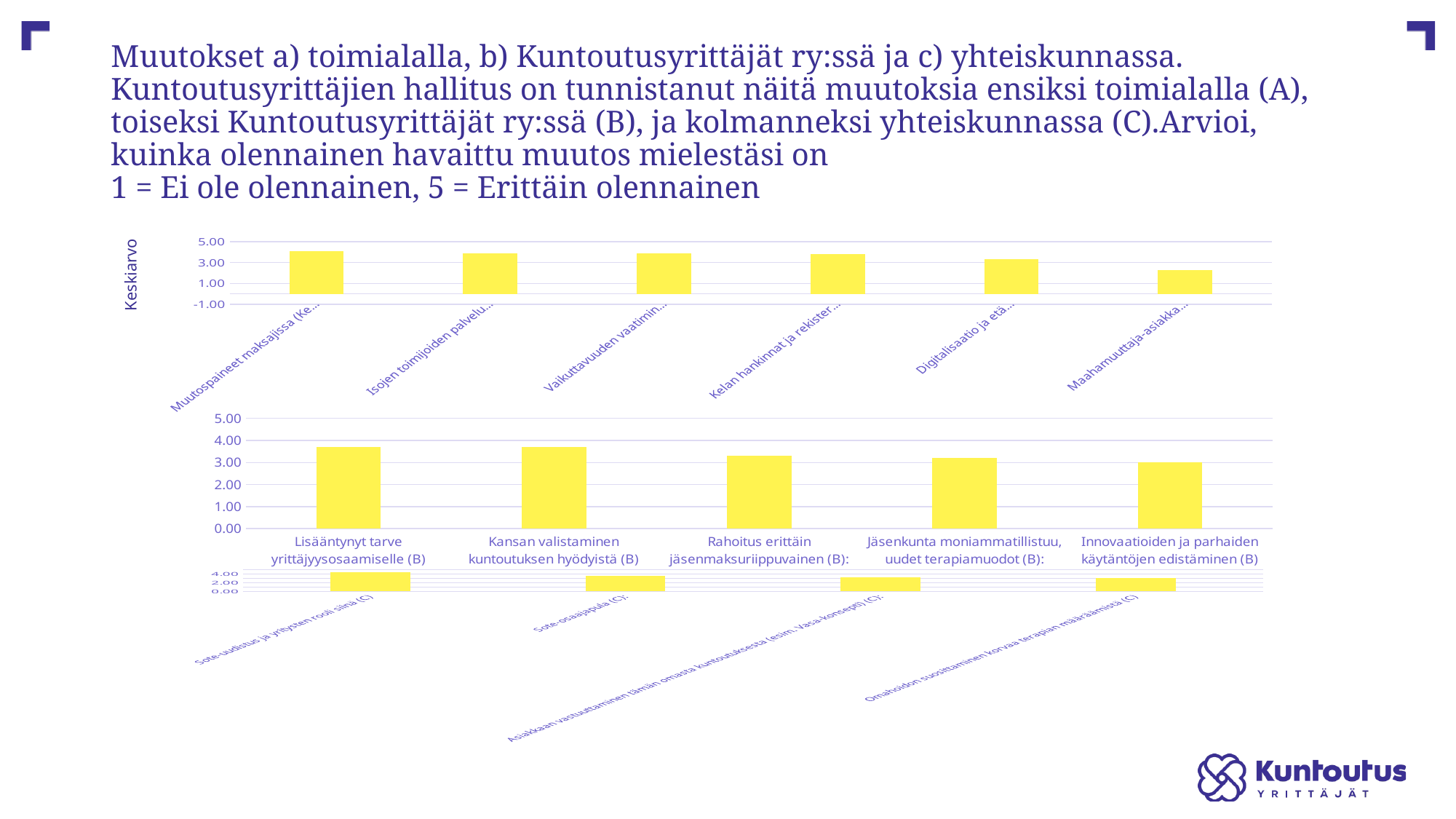
What colour are the bars in the charts on the slide? yellow How many bars does the bottom chart on the slide have? 4 What is the label on the vertical axis of the top chart? Keskiarvo In the middle chart, is the value for Lisääntynyt tarve yrittäjyysosaamiselle (B) greater or less than 3.00? greater How many charts are on the slide? 3 In the middle chart, which is larger: Lisääntynyt tarve yrittäjyysosaamiselle (B) or Rahoitus erittäin jäsenmaksuriippuvainen (B)? Lisääntynyt tarve yrittäjyysosaamiselle (B) How many bars does the middle chart on the slide have? 5 In the middle chart, is the value for Innovaatioiden ja parhaiden käytäntöjen edistäminen (B) greater or less than 4.00? less In the middle chart, which is larger: Kansan valistaminen kuntoutuksen hyödyistä (B) or Innovaatioiden ja parhaiden käytäntöjen edistäminen (B)? Kansan valistaminen kuntoutuksen hyödyistä (B) In the top chart, do the bar values rise or fall from left to right? fall What kind of chart is the top chart on the slide? bar chart